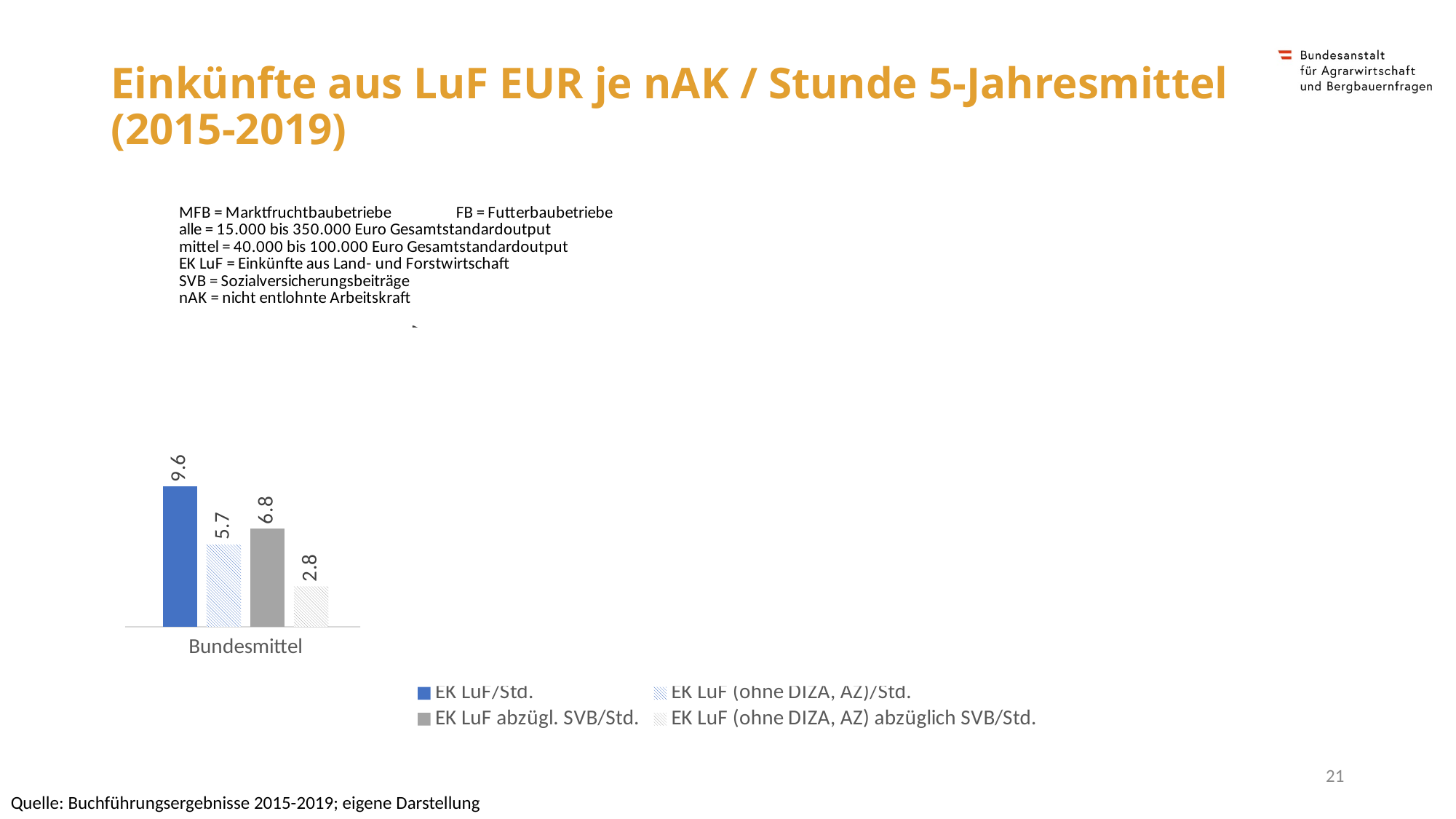
Which series has the highest value for Bundesmittel? EK LuF/Std. What type of chart is shown on the slide? bar chart Which is larger for Bundesmittel: EK LuF (ohne DIZA, AZ)/Std. or EK LuF abzügl. SVB/Std.? EK LuF abzügl. SVB/Std. What is the value of EK LuF (ohne DIZA, AZ) abzüglich SVB/Std. for Bundesmittel? 2.8 How many categories are shown on the x axis of the chart? 1 What is the value of EK LuF abzügl. SVB/Std. for Bundesmittel? 6.8 What is the value of EK LuF (ohne DIZA, AZ)/Std. for Bundesmittel? 5.7 What is the difference between EK LuF/Std. and EK LuF abzügl. SVB/Std. for Bundesmittel? 2.8 How many series does the legend list? 4 What is the difference between EK LuF (ohne DIZA, AZ)/Std. and EK LuF (ohne DIZA, AZ) abzüglich SVB/Std. for Bundesmittel? 2.9 What is the value of EK LuF/Std. for Bundesmittel? 9.6 Which series has the lowest value for Bundesmittel? EK LuF (ohne DIZA, AZ) abzüglich SVB/Std.